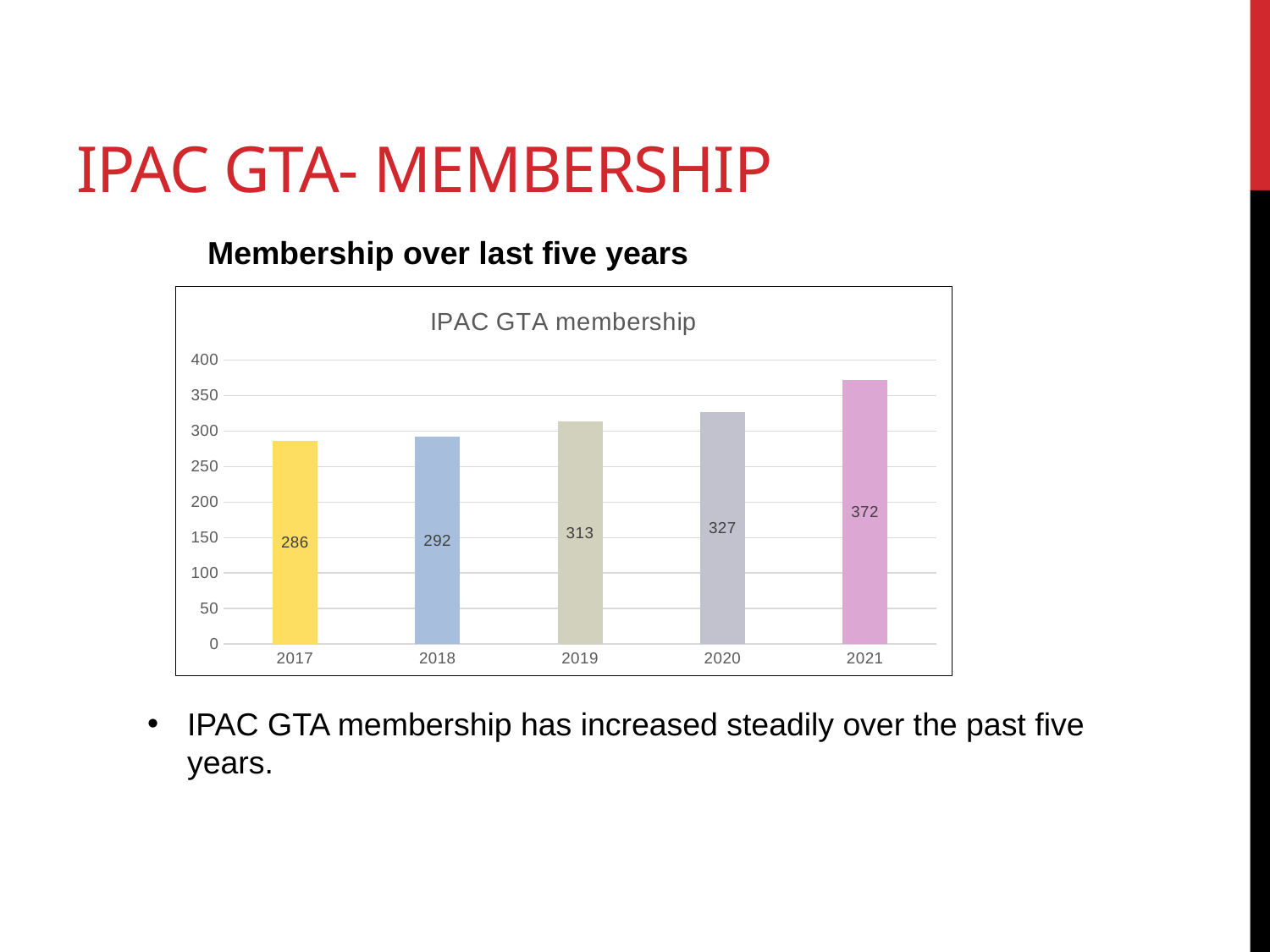
Which year has the lowest IPAC GTA membership? 2017 Which year has the highest IPAC GTA membership? 2021 How many years are shown on the x axis of the chart? 5 What is the IPAC GTA membership value for 2019? 313 What is the difference in membership between 2018 and 2017? 6 What kind of chart is used to show IPAC GTA membership? bar chart What is the title of the chart? IPAC GTA membership What is the difference in membership between 2021 and 2020? 45 Do the membership values rise or fall from 2017 to 2021? rise Is the membership value for 2021 greater or less than 350? greater What is the IPAC GTA membership value for 2017? 286 Which year has the larger membership, 2019 or 2020? 2020